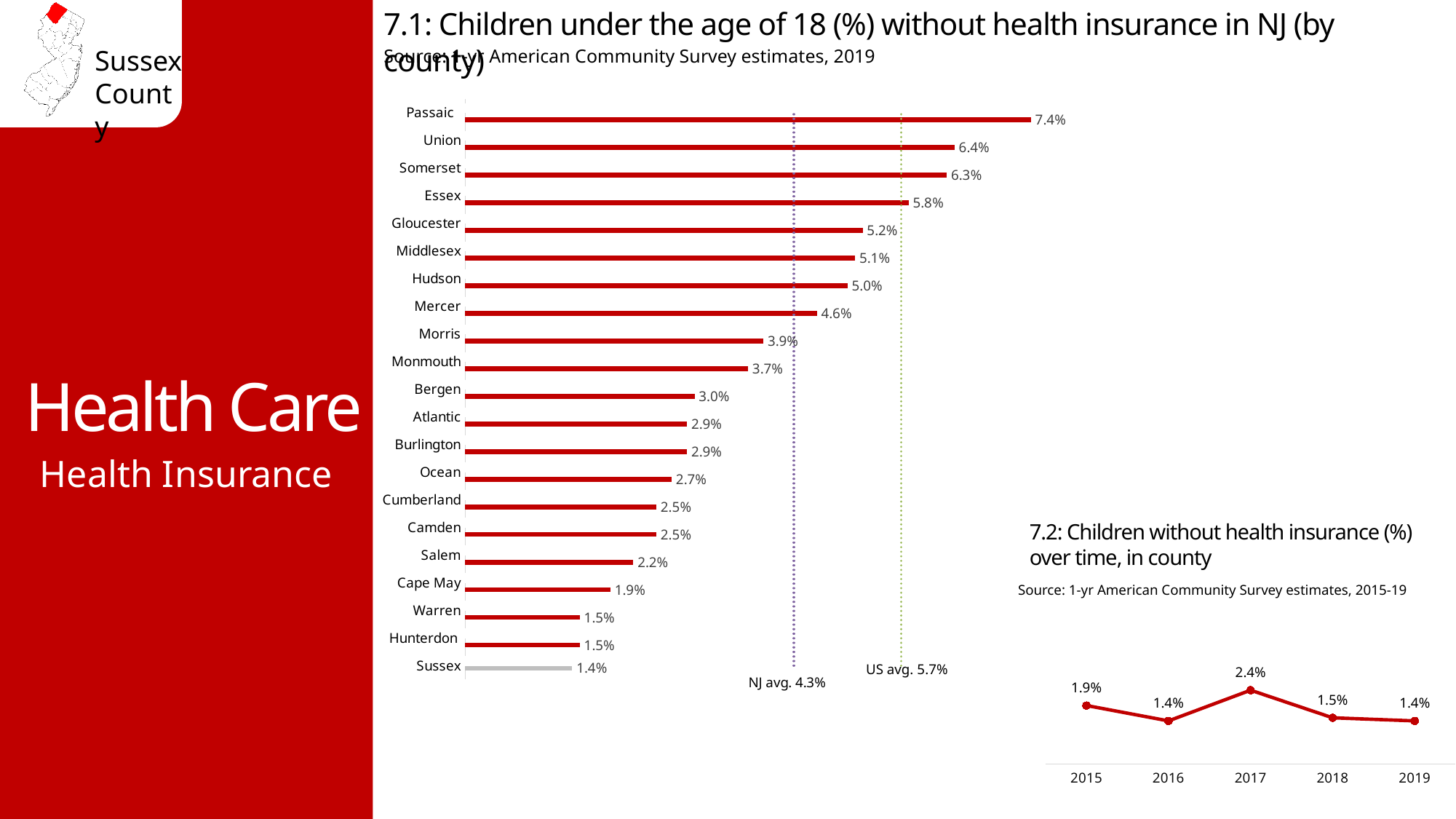
In chart 7.1, what is the value for Sussex? 1.4% In chart 7.1, how many counties are shown? 21 In chart 7.1, what is the NJ average shown by the dotted line? 4.3% In chart 7.2, which year has the highest percentage of children without health insurance? 2017 In chart 7.1, what is the difference between the values for Passaic and Sussex? 6.0% What kind of chart is chart 7.1? Bar chart In chart 7.2, what is the difference between the values for 2017 and 2016? 1.0% In chart 7.1, what is the percentage of children without health insurance in Passaic? 7.4% In chart 7.1, which county has the lowest percentage of children without health insurance? Sussex In chart 7.1, which county has the highest percentage of children without health insurance? Passaic In chart 7.2, what is the value for 2017? 2.4% In chart 7.1, which county has a higher value, Mercer or Morris? Mercer